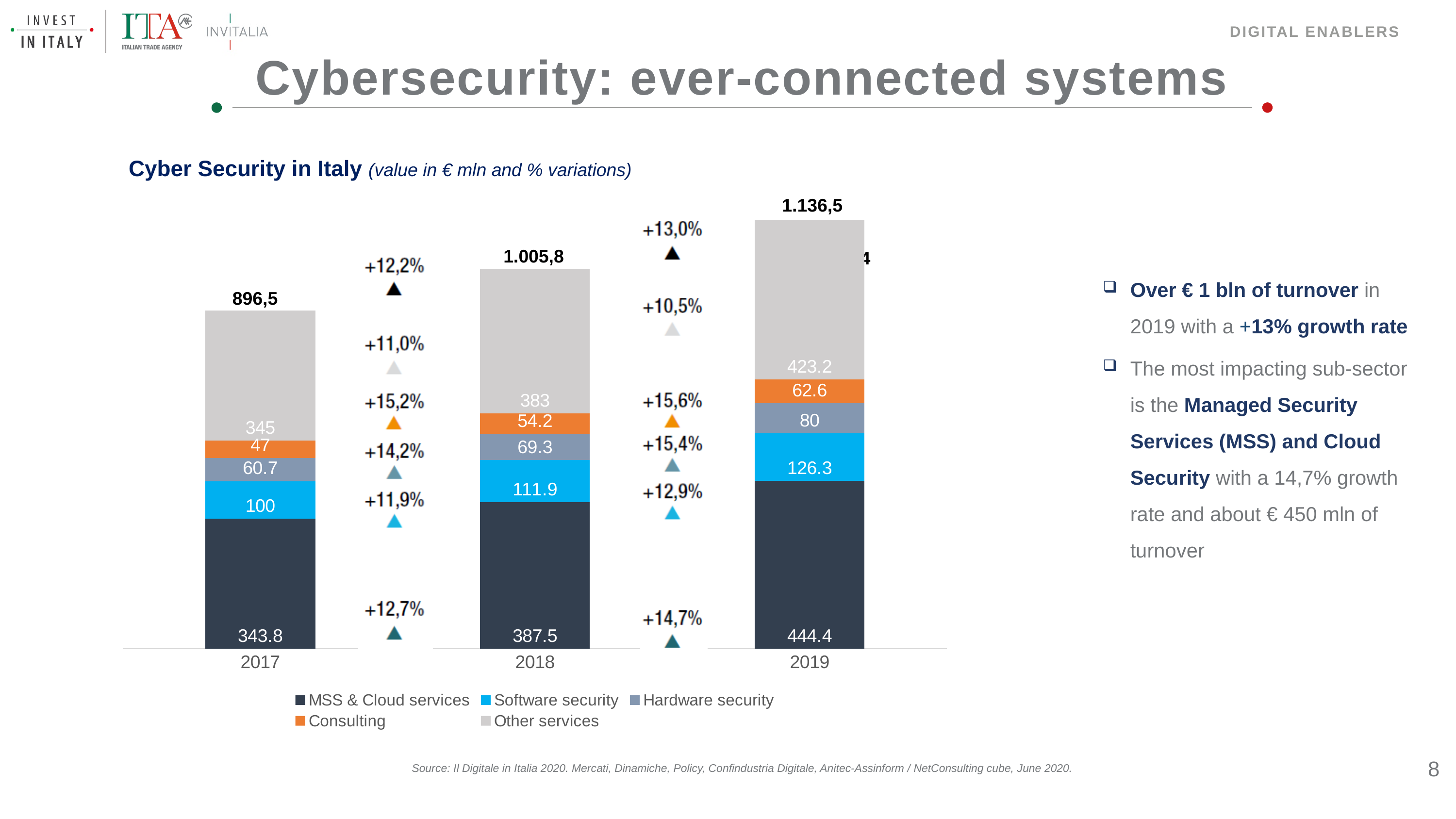
What is the difference between the Hardware security values for 2019 and 2018? 10.7 Which segment is the smallest in the 2019 bar? Consulting What is the value for Other services in 2017? 345 How many years are shown on the x axis? 3 How many series does the legend list? 5 What is the value for Software security in 2018? 111.9 What is the total value of the stacked bar for 2018? 1.005,8 What is the percentage variation shown for MSS & Cloud services between 2018 and 2019? +14,7% What kind of chart is shown? Stacked bar chart Which is larger in 2017: Consulting or Hardware security? Hardware security Which year has the highest total value? 2019 What is the value for MSS & Cloud services in 2019? 444.4